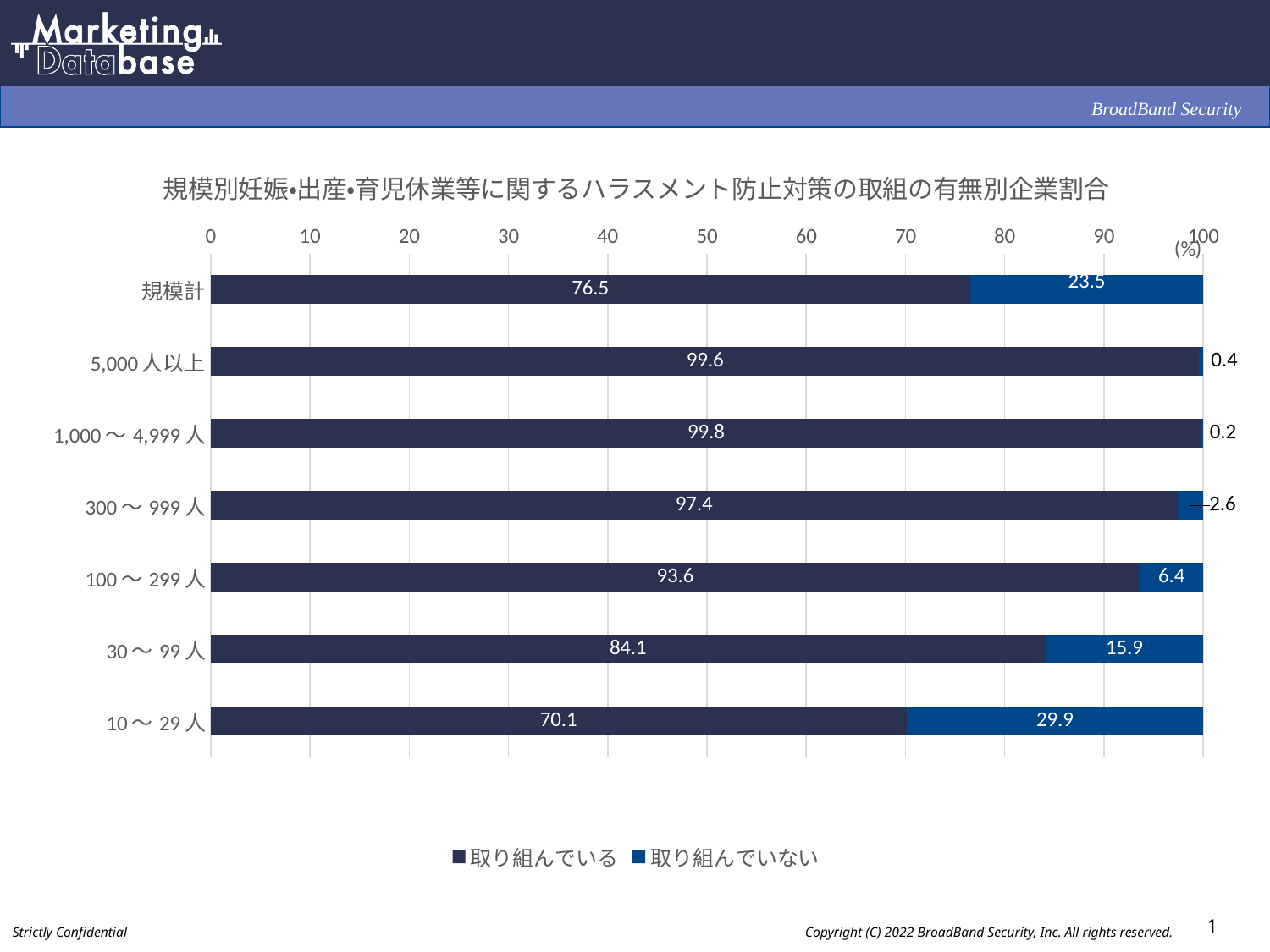
How many categories are shown on the vertical axis? 7 Which is larger, the 取り組んでいる value for 100〜299人 or for 30〜99人? 100〜299人 Which category has the lowest value for 取り組んでいる? 10〜29人 What is the difference between the 取り組んでいない values for 10〜29人 and 30〜99人? 14.0 How many series does the legend list? 2 What is the value of 取り組んでいない for 5,000人以上? 0.4 What is the total of the stacked bar for 300〜999人? 100 What kind of chart is shown on the slide? Stacked bar chart Which category has the highest value for 取り組んでいる? 1,000〜4,999人 What is the title of the chart? 規模別妊娠•出産•育児休業等に関するハラスメント防止対策の取組の有無別企業割合 What is the value of 取り組んでいる for 規模計? 76.5 What is the value of 取り組んでいない for 10〜29人? 29.9